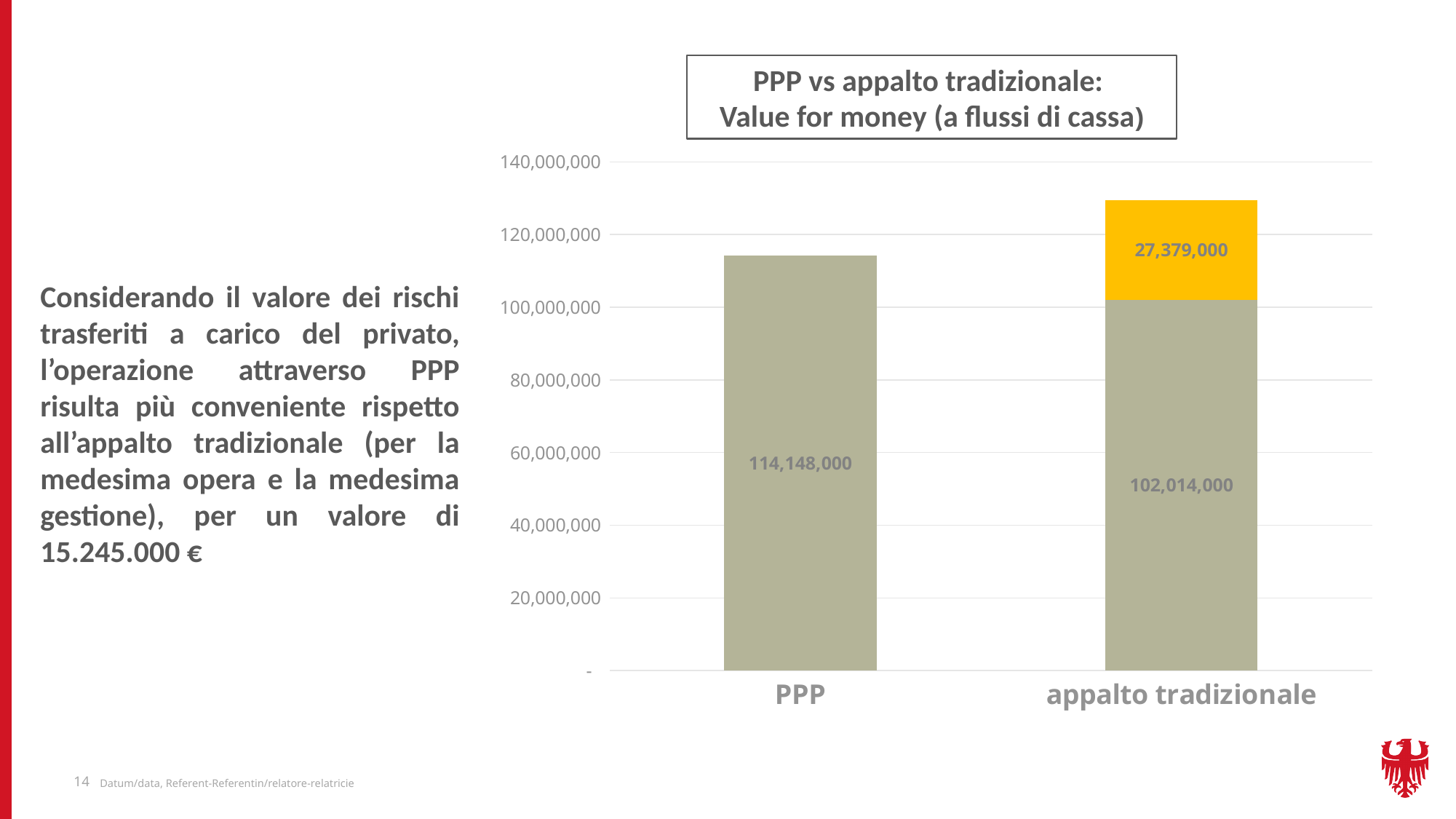
What kind of chart is shown on the slide? bar chart What is the total of the stacked appalto tradizionale bar? 129,393,000 Is the value for PPP greater or less than 100,000,000? greater What is the value shown for the PPP bar? 114,148,000 What is the value of the grey (lower) segment of the appalto tradizionale bar? 102,014,000 How many categories are shown on the x axis? 2 Is the total height of the appalto tradizionale bar greater or less than 120,000,000? greater What is the value of the yellow (upper) segment of the appalto tradizionale bar? 27,379,000 Which bar is taller overall, PPP or appalto tradizionale? appalto tradizionale What is the title of the chart? PPP vs appalto tradizionale: Value for money (a flussi di cassa) By how much does the total of the appalto tradizionale bar exceed the PPP value? 15,245,000 What is the difference between the PPP value and the grey segment of the appalto tradizionale bar? 12,134,000